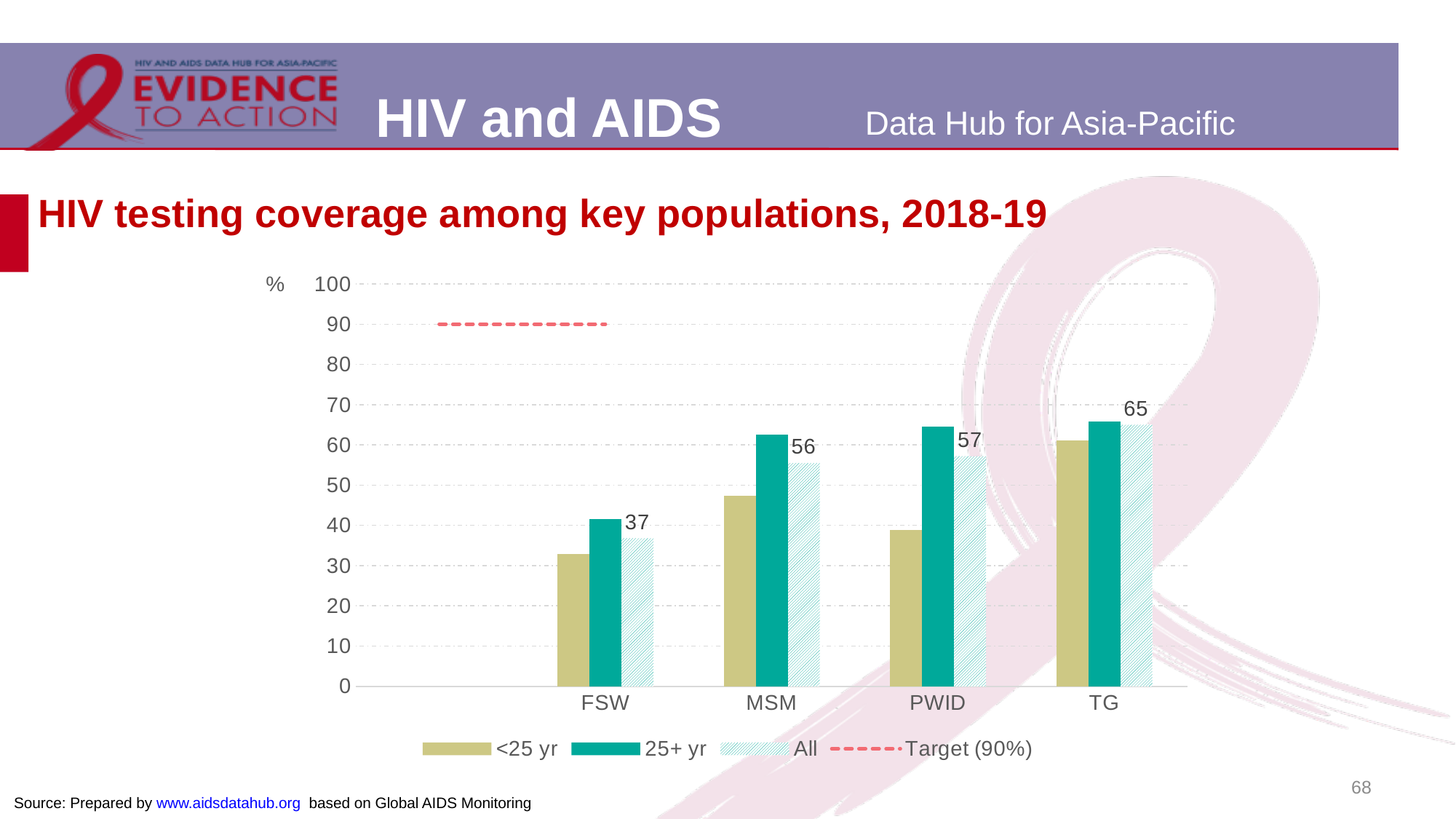
Is the value for <25 yr for FSW greater or less than 40? less Which is larger, the All value for PWID or the All value for MSM? PWID What is the difference between the All values for TG and FSW? 28 What is the value for the All series for TG? 65 Which key population has the lowest value for the All series? FSW How many entries does the legend list? 4 Is the value for 25+ yr for PWID greater or less than 60? greater Which key population has the highest value for the All series? TG What kind of chart is shown on the slide? Bar chart What is the value for the All series for FSW? 37 What is the value for the All series for PWID? 57 How many key populations are shown on the x axis? 4